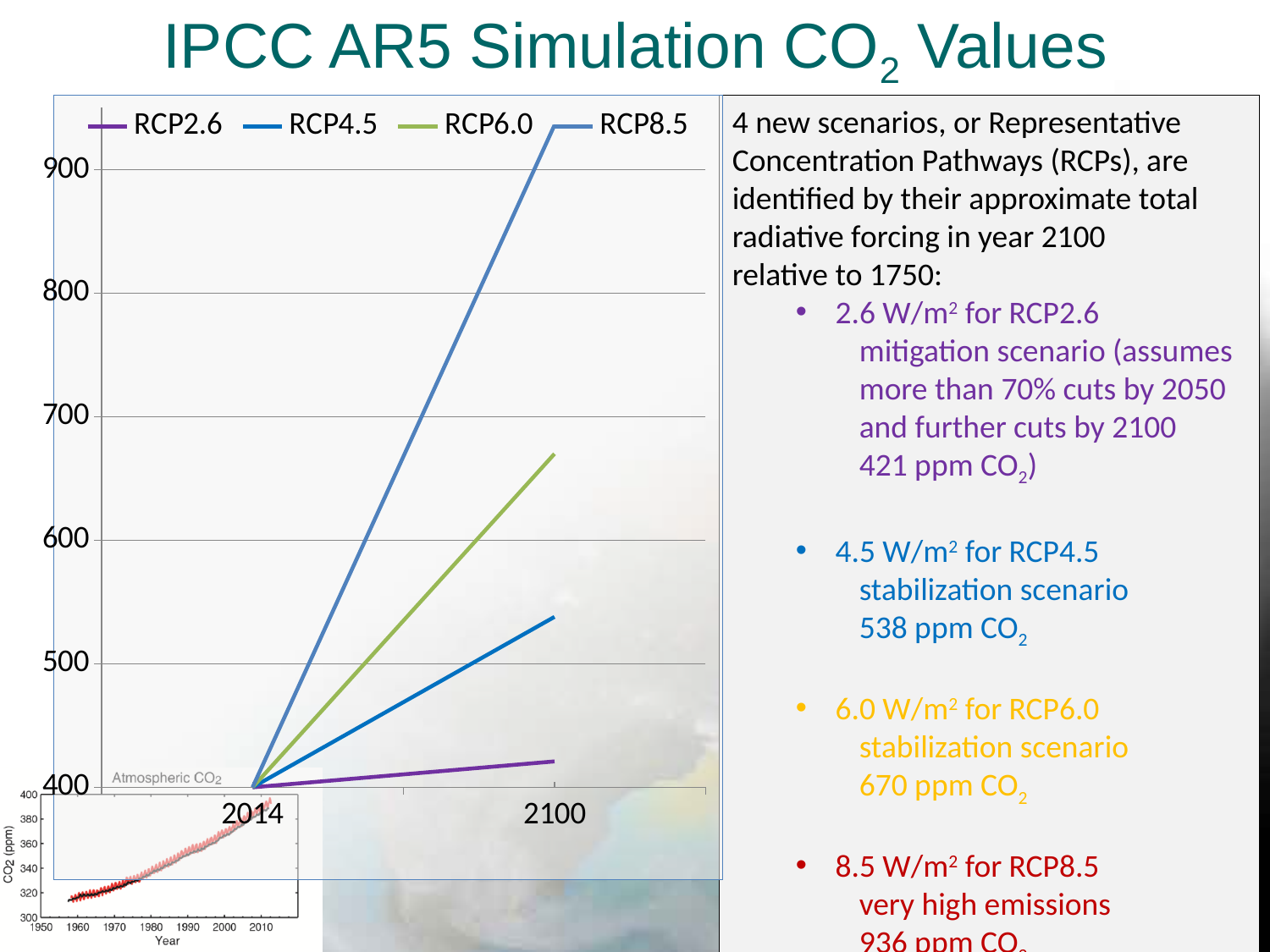
In the main chart, does the RCP8.5 line rise or fall from 2014 to 2100? rise What kind of chart is the main chart on the slide? line chart How many series does the legend of the main chart list? 4 In the main chart, is the value for RCP4.5 in 2100 greater or less than 500? greater In the main chart, which scenario has the highest CO2 value in 2100? RCP8.5 In the main chart, is the value for RCP6.0 in 2100 greater or less than 700? less In the small inset chart of atmospheric CO2, does the value rise or fall from 1960 to 2010? rise What are the two year labels shown on the x axis of the main chart? 2014 and 2100 In the main chart, is the value for RCP8.5 in 2100 greater or less than 900? greater In the main chart, which scenario has the lowest CO2 value in 2100? RCP2.6 In the main chart, which is higher in 2100: RCP6.0 or RCP4.5? RCP6.0